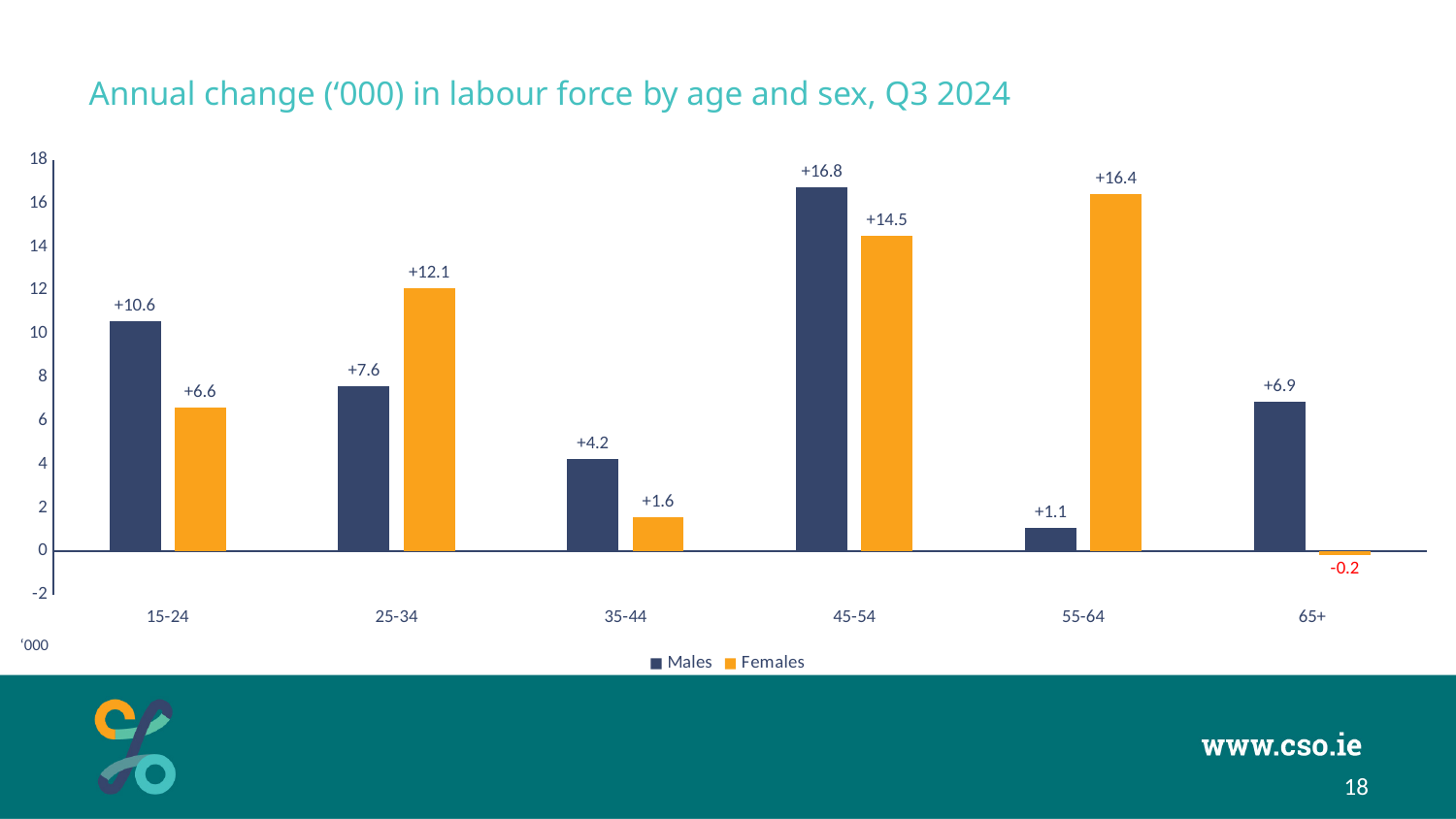
What is the value for Females in the 65+ age group? -0.2 What kind of chart is shown on the slide? Bar chart How many age groups are shown on the x axis? 6 What is the title of the chart? Annual change ('000) in labour force by age and sex, Q3 2024 Which age group has the highest value for Females? 55-64 Which age group has the lowest value for Males? 55-64 What is the difference between the Males and Females values in the 15-24 age group? 4.0 What is the value for Females in the 25-34 age group? +12.1 How many series does the legend list? 2 Which is larger in the 35-44 age group, the Males value or the Females value? Males Is the value for Females in the 45-54 age group greater or less than 14? greater What is the value for Males in the 45-54 age group? +16.8